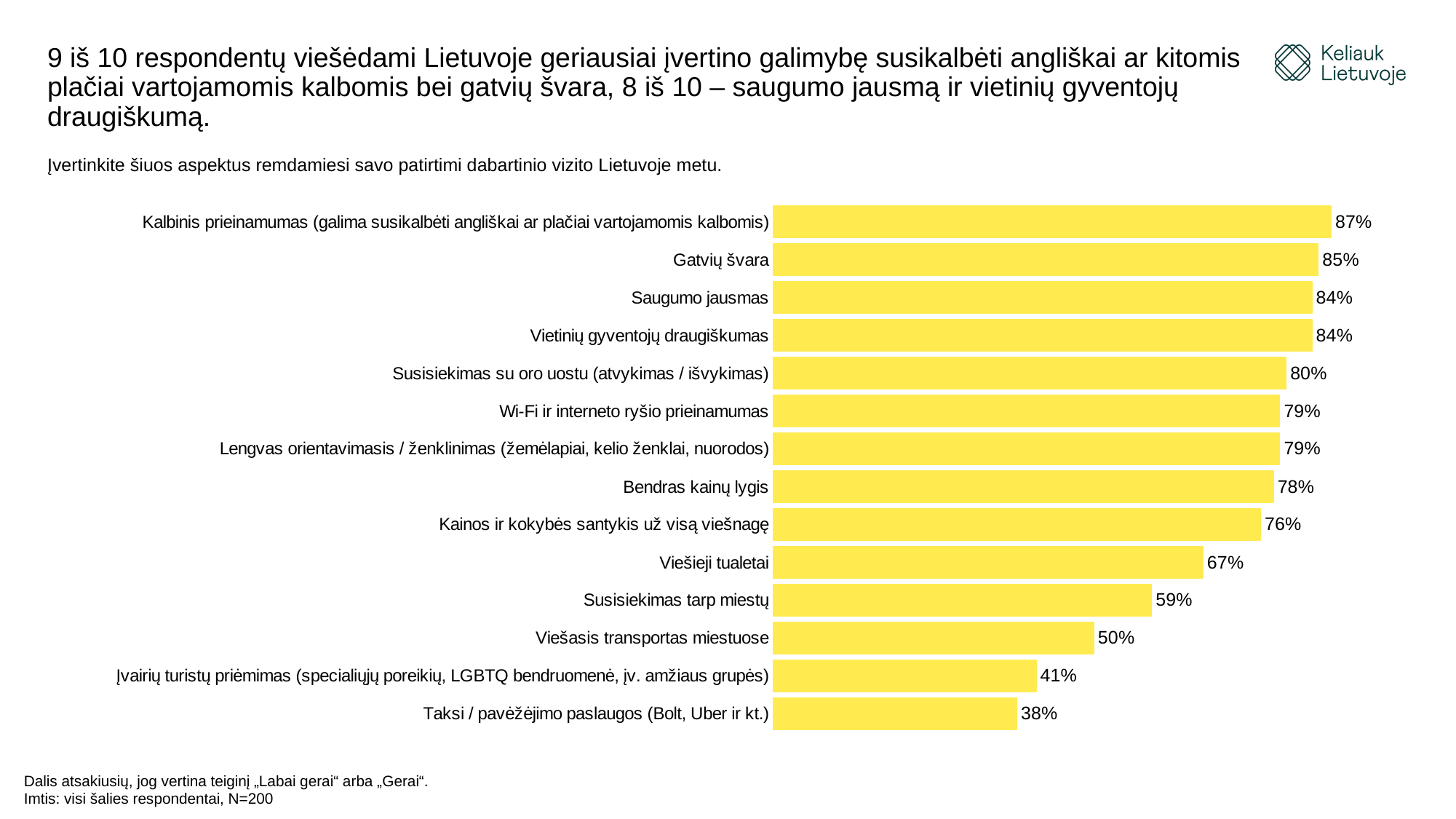
Which category has the lowest value? Taksi / pavėžėjimo paslaugos (Bolt, Uber ir kt.) What is the value for Viešieji tualetai? 67% Which is larger, the value for Bendras kainų lygis or the value for Kainos ir kokybės santykis už visą viešnagę? Bendras kainų lygis How many categories are shown in the chart? 14 What kind of chart is shown on the slide? Bar chart What is the difference between the values for Kalbinis prieinamumas and Taksi / pavėžėjimo paslaugos? 49% What is the difference between the values for Susisiekimas tarp miestų and Viešasis transportas miestuose? 9% What colour are the bars in the chart? Yellow What is the value for Taksi / pavėžėjimo paslaugos (Bolt, Uber ir kt.)? 38% What is the value for Gatvių švara? 85% Which is larger, the value for Viešieji tualetai or the value for Įvairių turistų priėmimas? Viešieji tualetai Which category has the highest value? Kalbinis prieinamumas (galima susikalbėti angliškai ar plačiai vartojamomis kalbomis)